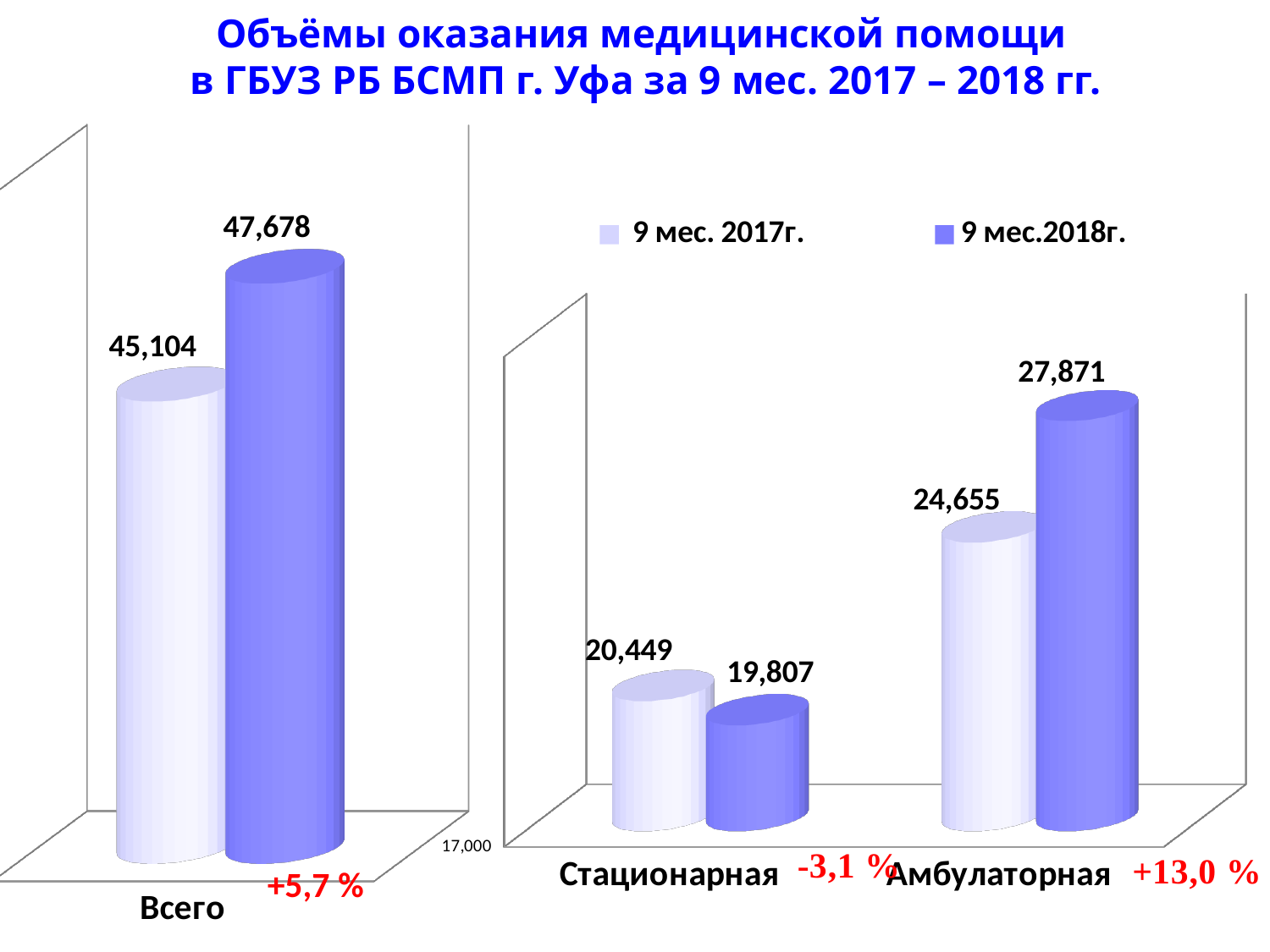
On the right chart, what is the value for Стационарная in 9 мес.2018г.? 19,807 How many series does the legend list? 2 On the left chart (Всего), what is the value for 9 мес. 2017г.? 45,104 What kind of chart is the right chart? Bar chart On the left chart (Всего), what is the difference between the 9 мес.2018г. and 9 мес. 2017г. values? 2,574 On the right chart, what is the value for Амбулаторная in 9 мес. 2017г.? 24,655 On the right chart, which category has the lowest value in 9 мес. 2017г.? Стационарная On the right chart, which is larger for Амбулаторная: the 9 мес. 2017г. value or the 9 мес.2018г. value? 9 мес.2018г. On the right chart, which category has the highest value in 9 мес.2018г.? Амбулаторная On the right chart, what is the difference between the 9 мес. 2017г. and 9 мес.2018г. values for Стационарная? 642 On the left chart (Всего), what is the value for 9 мес.2018г.? 47,678 On the right chart, how many categories are shown on the x axis? 2